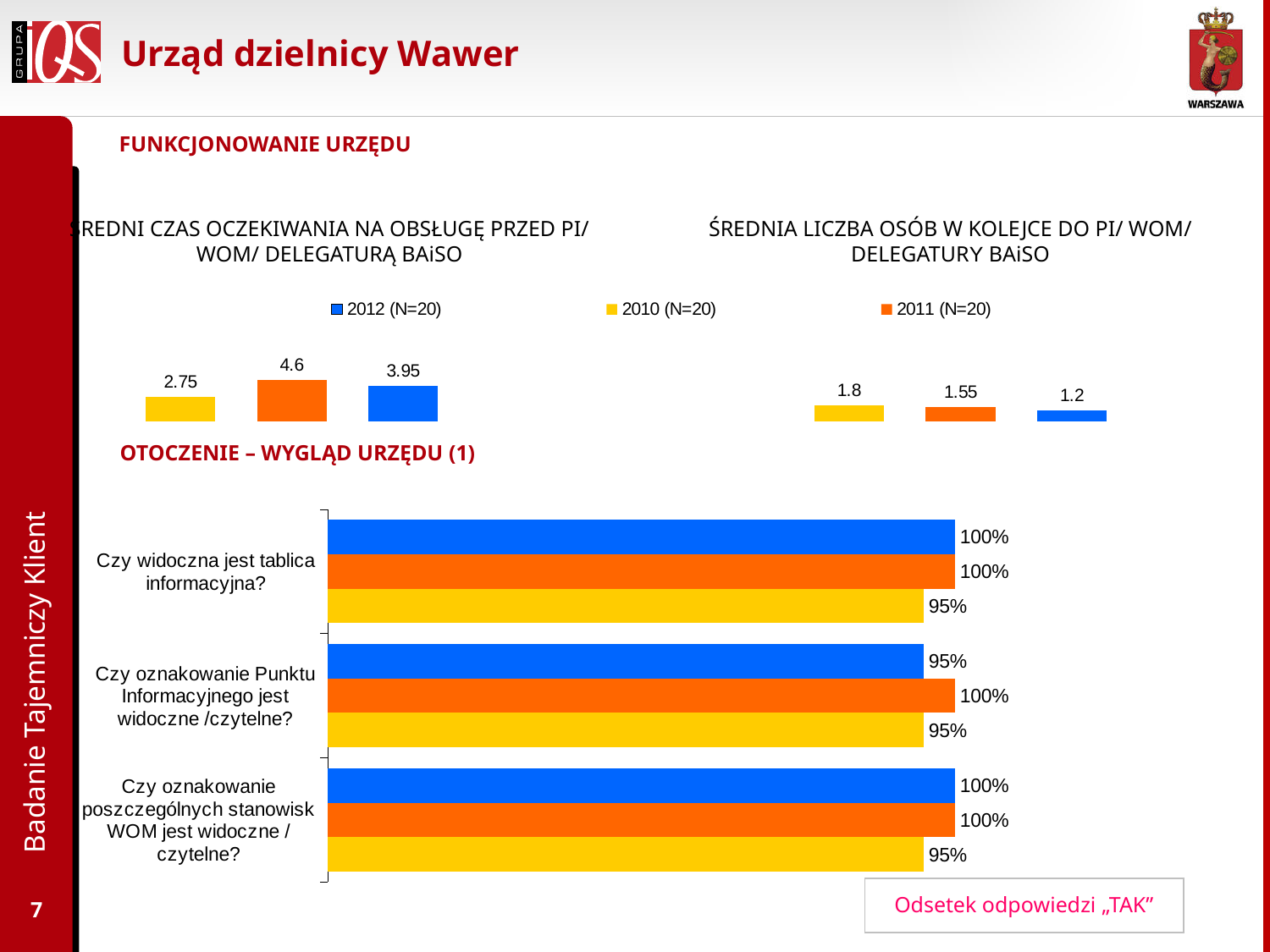
In the bottom chart under 'OTOCZENIE – WYGLĄD URZĘDU (1)', what is the 2012 (blue) value for 'Czy oznakowanie Punktu Informacyjnego jest widoczne /czytelne?'? 95% In the bottom chart under 'OTOCZENIE – WYGLĄD URZĘDU (1)', what is the 2010 (yellow) value for 'Czy widoczna jest tablica informacyjna?'? 95% How many series does the legend above the top charts list? 3 In the chart titled 'ŚREDNIA LICZBA OSÓB W KOLEJCE DO PI/ WOM/ DELEGATURY BAiSO', is the value for 2011 larger or smaller than the value for 2012? larger In the chart titled 'ŚREDNI CZAS OCZEKIWANIA NA OBSŁUGĘ PRZED PI/ WOM/ DELEGATURĄ BAiSO', what is the value for 2011 (N=20)? 4.6 In the chart titled 'ŚREDNIA LICZBA OSÓB W KOLEJCE DO PI/ WOM/ DELEGATURY BAiSO', what is the value for 2012 (N=20)? 1.2 What type of chart is the bottom chart under 'OTOCZENIE – WYGLĄD URZĘDU (1)'? bar chart How many question categories are shown in the bottom chart under 'OTOCZENIE – WYGLĄD URZĘDU (1)'? 3 In the chart titled 'ŚREDNI CZAS OCZEKIWANIA NA OBSŁUGĘ PRZED PI/ WOM/ DELEGATURĄ BAiSO', which year has the lowest value? 2010 (N=20) In the chart titled 'ŚREDNIA LICZBA OSÓB W KOLEJCE DO PI/ WOM/ DELEGATURY BAiSO', which year has the highest value? 2010 (N=20) In the chart titled 'ŚREDNIA LICZBA OSÓB W KOLEJCE DO PI/ WOM/ DELEGATURY BAiSO', what is the difference between the 2010 and 2012 values? 0.6 In the chart titled 'ŚREDNI CZAS OCZEKIWANIA NA OBSŁUGĘ PRZED PI/ WOM/ DELEGATURĄ BAiSO', what is the difference between the 2011 and 2010 values? 1.85